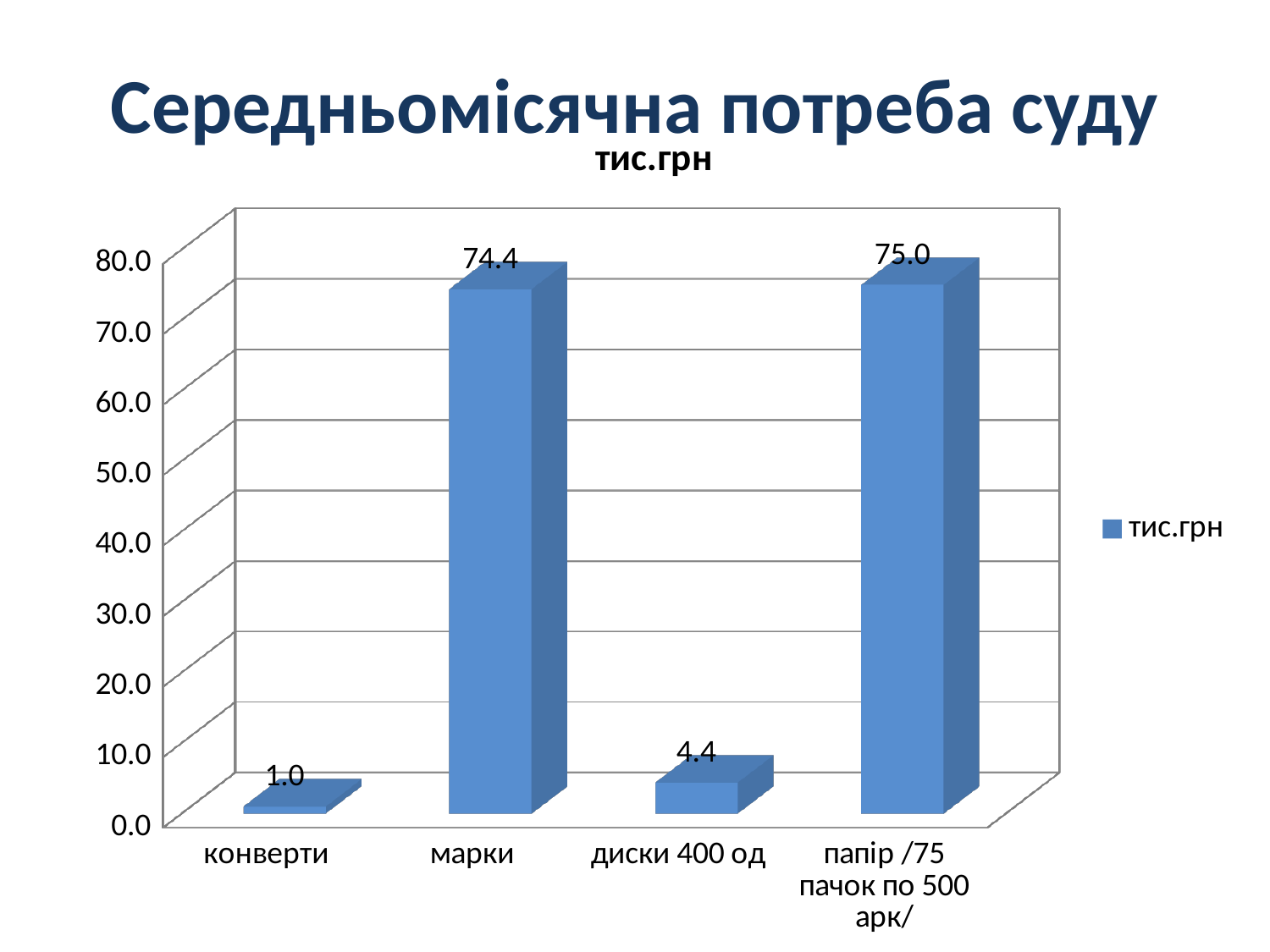
What is the difference between the values for диски 400 од and конверти? 3.4 How many categories are shown on the chart? 4 What is the value for марки? 74.4 Which category has the lowest value? конверти What is the title of the chart? тис.грн What is the value for конверти? 1.0 What is the value for папір /75 пачок по 500 арк/? 75.0 Which is larger, the value for марки or the value for диски 400 од? марки Which category has the highest value? папір /75 пачок по 500 арк/ What is the value for диски 400 од? 4.4 What kind of chart is shown on the slide? bar chart What is the difference between the values for папір /75 пачок по 500 арк/ and марки? 0.6